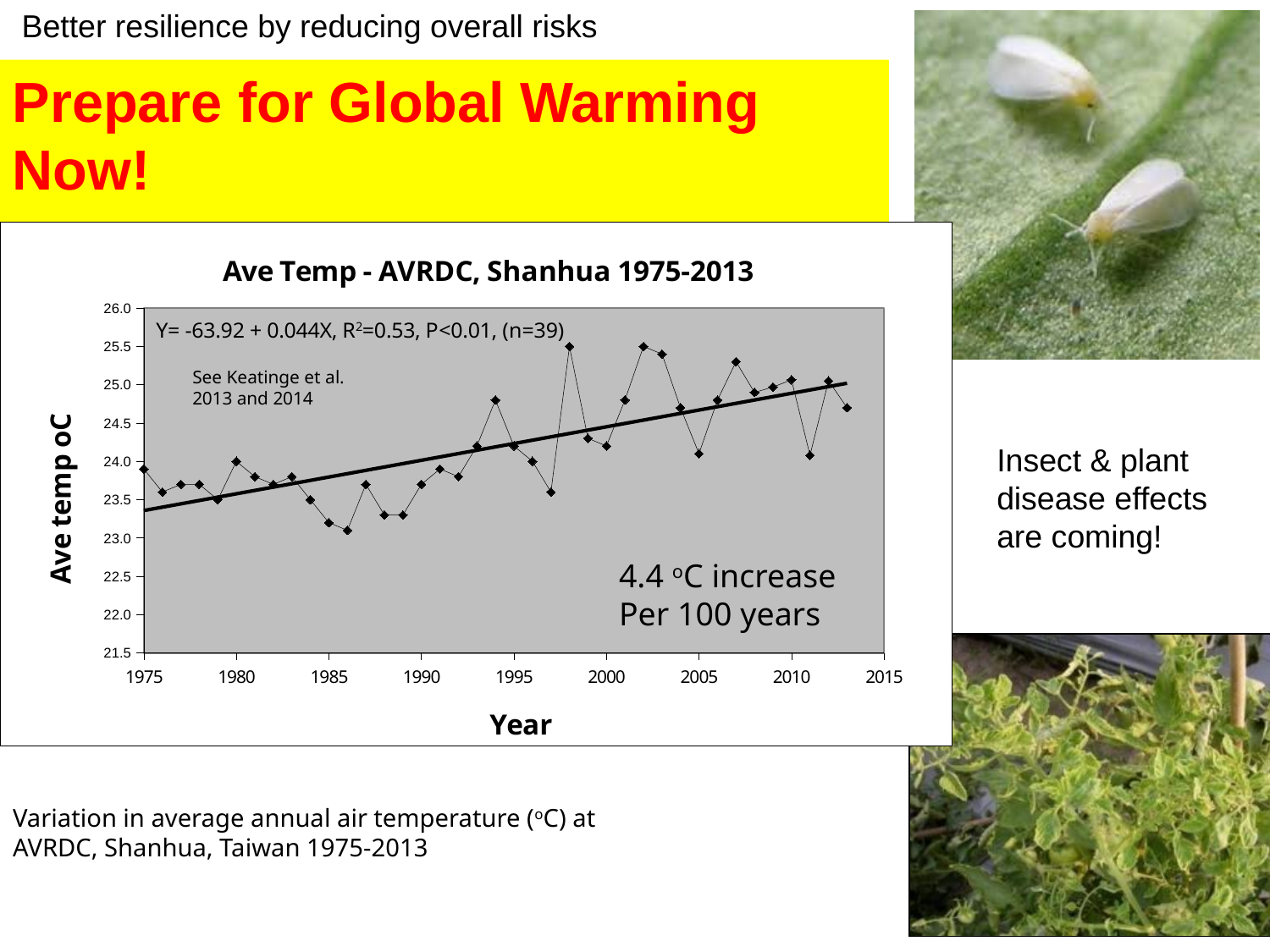
Is the average temperature value for 2007 greater or less than 25.0? greater What kind of chart is shown on the slide? line chart Which year has the higher average temperature, 1998 or 1986? 1998 Which year has the higher average temperature, 2002 or 1997? 2002 Is the average temperature value for 1986 greater or less than 23.5? less According to the chart's annotation, what is the temperature increase per 100 years? 4.4 °C How many data points (n) does the chart's annotation say are plotted? 39 Is the average temperature value for 2011 greater or less than 24.5? less What is the label of the y axis of the chart? Ave temp oC What is the title of the chart? Ave Temp - AVRDC, Shanhua 1975-2013 Overall, do the average temperature values rise or fall from 1975 to 2013? rise